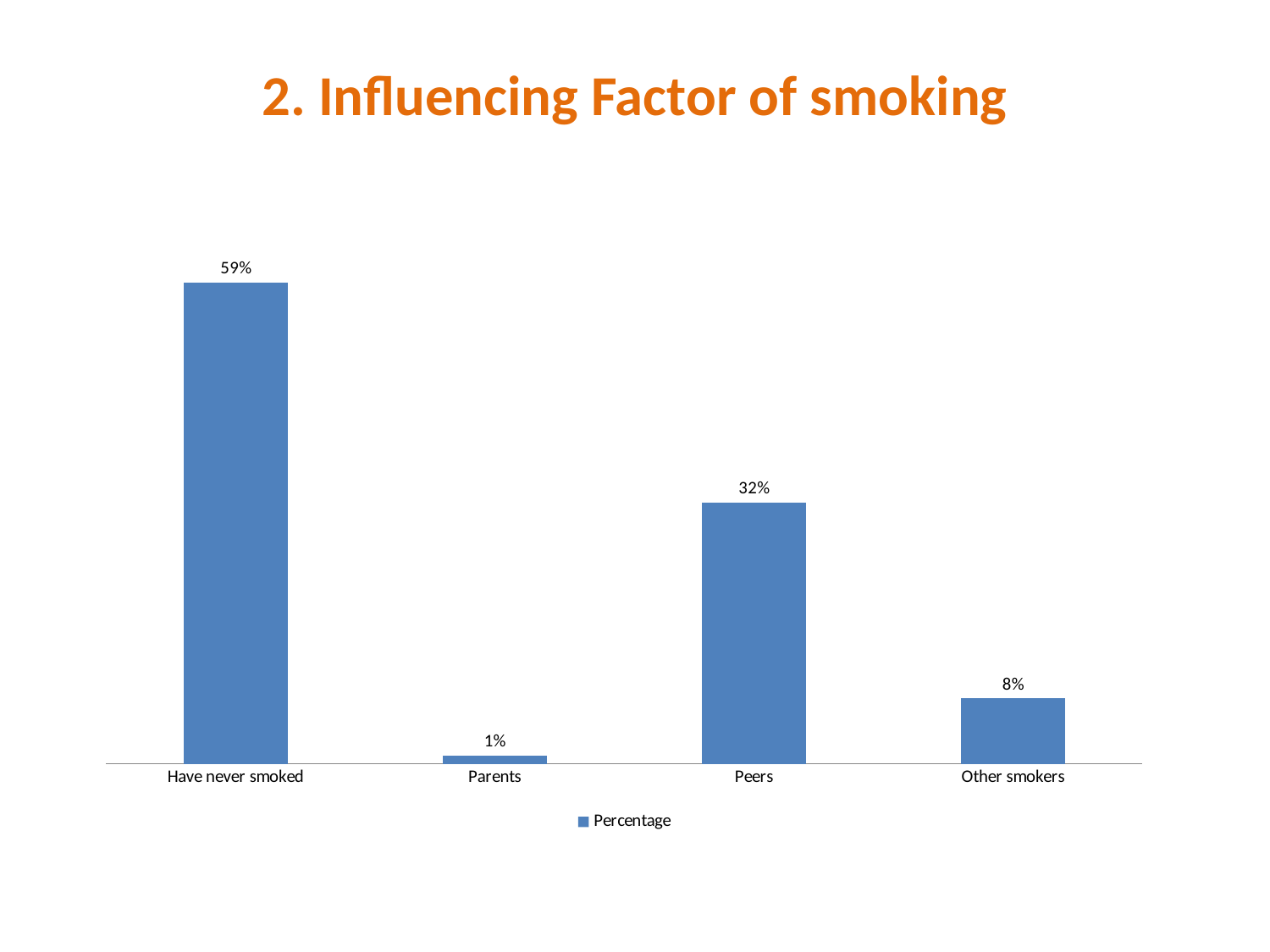
What is the percentage for Parents? 1% What is the percentage for Have never smoked? 59% What is the percentage for Other smokers? 8% Which has a larger percentage, Other smokers or Parents? Other smokers Which category has the lowest percentage? Parents What is the percentage for Peers? 32% What is the difference in percentage between Have never smoked and Peers? 27% Which category has the highest percentage? Have never smoked What series name does the legend show? Percentage What kind of chart is shown on the slide? Bar chart How many categories are shown on the x axis? 4 What is the difference in percentage between Peers and Other smokers? 24%